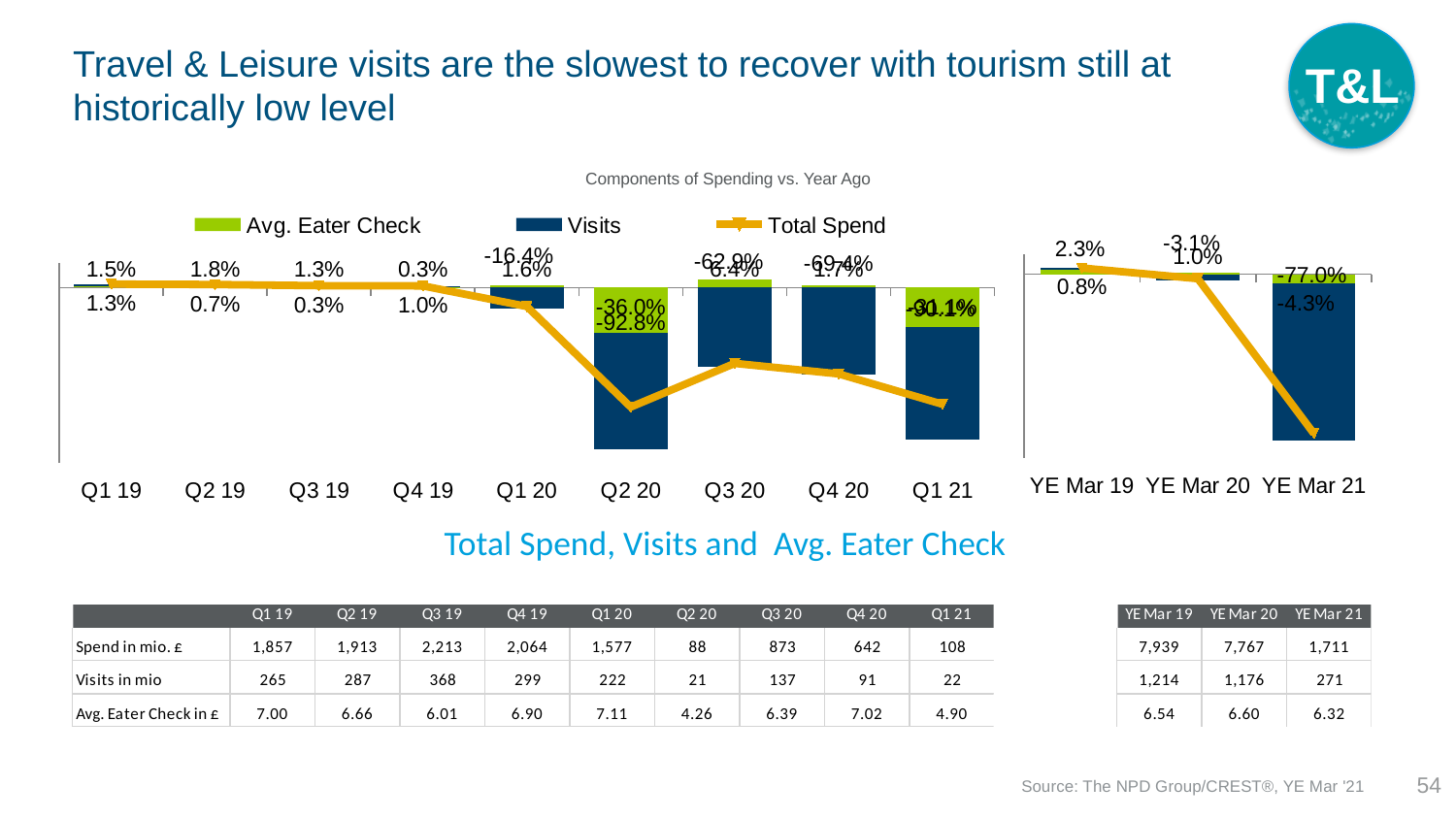
What kind of chart is the left chart titled 'Components of Spending vs. Year Ago'? A bar chart with a line How many quarters are shown on the x axis of the left chart? 9 In the left chart, what is the Visits value for Q2 20? -92.8% How many series does the legend of the left chart list? 3 In the right chart, what is the Visits value for YE Mar 21? -77.0% In the left chart, which quarter has the lowest Total Spend point on the line? Q2 20 In the right chart, what is the Avg. Eater Check value for YE Mar 21? -4.3% How many periods are shown on the x axis of the right chart (YE Mar)? 3 In the left chart, what is the Avg. Eater Check value for Q2 20? -36.0% In the left chart, is the Visits value larger in Q2 20 or Q3 20? Q3 20 In the left chart, does the Total Spend line rise or fall from Q4 19 to Q2 20? Fall What are the three legend entries of the left chart? Avg. Eater Check, Visits, Total Spend